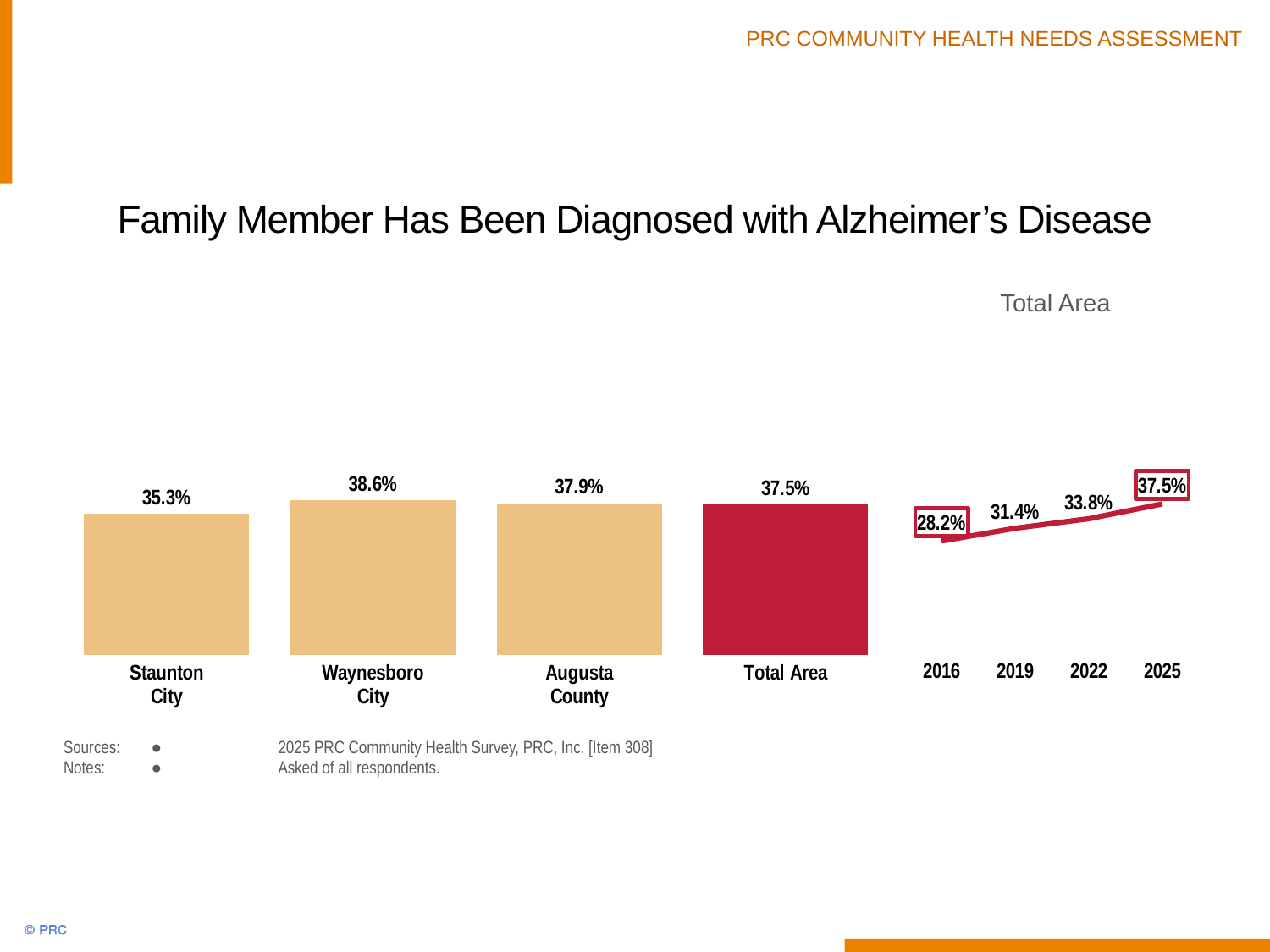
In the Total Area trend chart on the right, what is the value for 2022? 33.8% What is the title of the slide's chart? Family Member Has Been Diagnosed with Alzheimer’s Disease In the bar chart on the left, which category has the highest value? Waynesboro City In the Total Area trend chart on the right, do the values rise or fall from 2016 to 2025? rise In the bar chart on the left, which category has the lowest value? Staunton City What kind of chart is the chart on the left? bar chart In the Total Area trend chart on the right, what is the difference between the 2025 and 2016 values? 9.3% In the Total Area trend chart on the right, what is the value for 2016? 28.2% In the bar chart on the left, what is the value for Waynesboro City? 38.6% In the bar chart on the left, how many categories are shown? 4 In the bar chart on the left, what is the difference between Waynesboro City and Staunton City? 3.3% In the bar chart on the left, what is the value for Staunton City? 35.3%